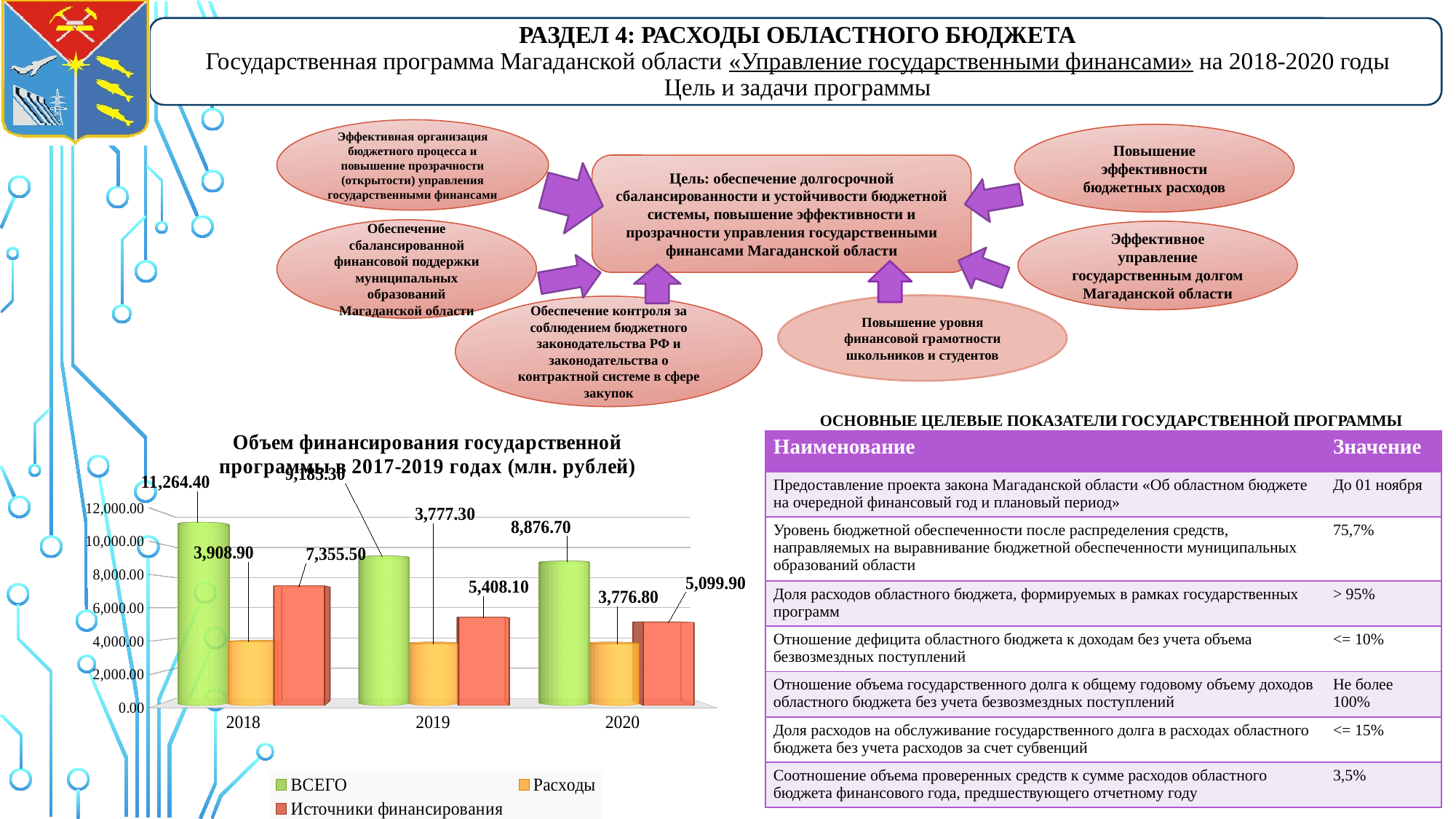
Is the ВСЕГО value for 2020 greater or less than 10,000.00? less What is the value of Расходы for 2019 in the chart? 3,777.30 What is the difference between ВСЕГО and Расходы for 2020 in the chart? 5,099.90 In which year is the ВСЕГО value highest in the chart? 2018 What is the value of Источники финансирования for 2018 in the chart? 7,355.50 Which is larger in 2018: Расходы or Источники финансирования? Источники финансирования What kind of chart is used to show the programme financing volume? bar chart How many series does the chart legend list? 3 In which year is the Источники финансирования value lowest in the chart? 2020 What is the value of Источники финансирования for 2020 in the chart? 5,099.90 What is the value of ВСЕГО for 2018 in the chart? 11,264.40 How many years are shown on the x axis of the chart? 3